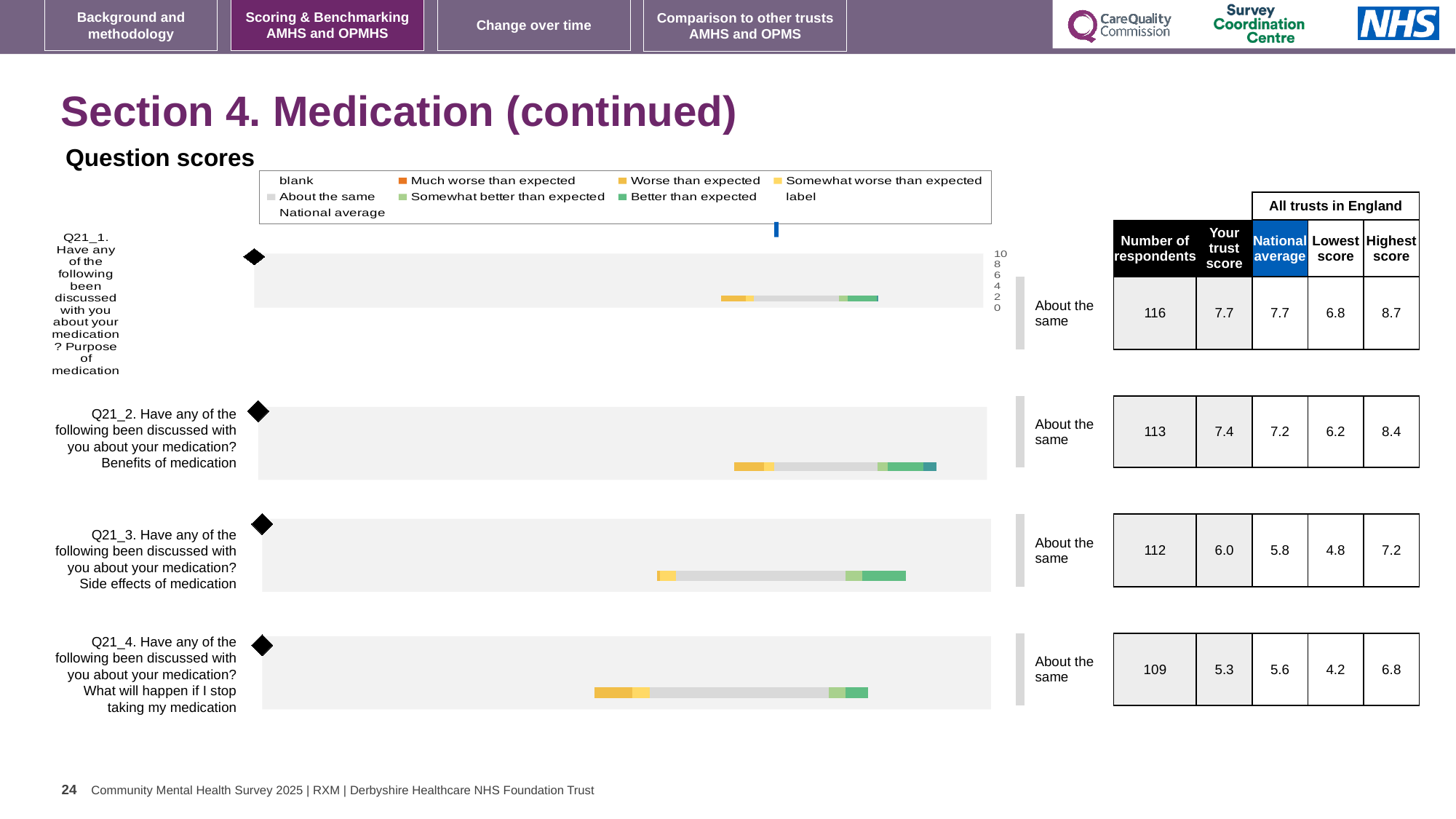
What is the lowest score across all trusts in England shown for Q21_2 (Benefits of medication)? 6.2 What is the national average shown for Q21_3 (Side effects of medication)? 5.8 For Q21_1 (Purpose of medication), what is the difference between the highest score and the lowest score across all trusts in England? 1.9 For Q21_2, which is larger: the trust score or the national average? Your trust score For Q21_4, which is larger: the trust score or the national average? National average Which question has the highest 'Your trust score' on this slide? Q21_1 (Purpose of medication) How many respondents are shown for Q21_4 (What will happen if I stop taking my medication)? 109 How many question charts are shown on this slide? 4 Which question has the lowest 'Your trust score' on this slide? Q21_4 (What will happen if I stop taking my medication) What is the 'Your trust score' value shown for Q21_2 (Benefits of medication)? 7.4 What benchmark label is shown next to the chart for Q21_3 (Side effects of medication)? About the same What kind of chart is used to show each question score? Bar chart